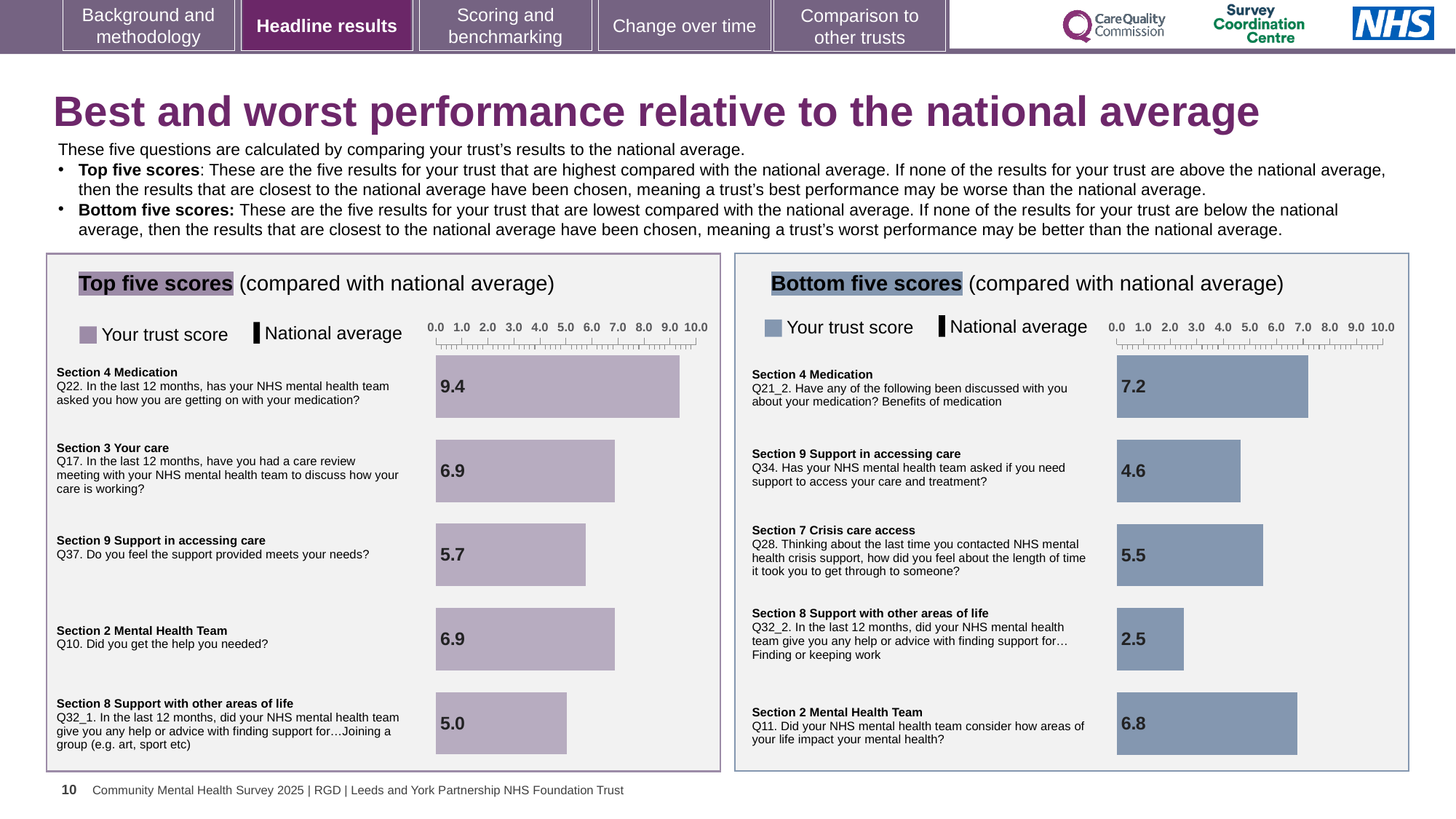
In the Bottom five scores chart, what is the trust score for Q11 (consider how areas of your life impact your mental health)? 6.8 In the Bottom five scores chart, which has the larger trust score, Q28 or Q34? Q28 What kind of chart is the Bottom five scores chart? Bar chart In the Bottom five scores chart, which question has the lowest trust score? Q32_2 In the Bottom five scores chart, which question has the highest trust score? Q21_2 In the Bottom five scores chart, what is the trust score for Q34 (asked if you need support to access your care and treatment)? 4.6 In the Top five scores chart, what is the trust score for Q37 (do you feel the support provided meets your needs)? 5.7 In the Top five scores chart, which question has the highest trust score? Q22 In the Top five scores chart, what is the trust score for Q22 (asked how you are getting on with your medication)? 9.4 In the Top five scores chart, what is the difference between the trust scores for Q22 and Q32_1? 4.4 In the Bottom five scores chart, what is the difference between the trust scores for Q21_2 and Q32_2? 4.7 How many questions are plotted in the Top five scores chart? 5